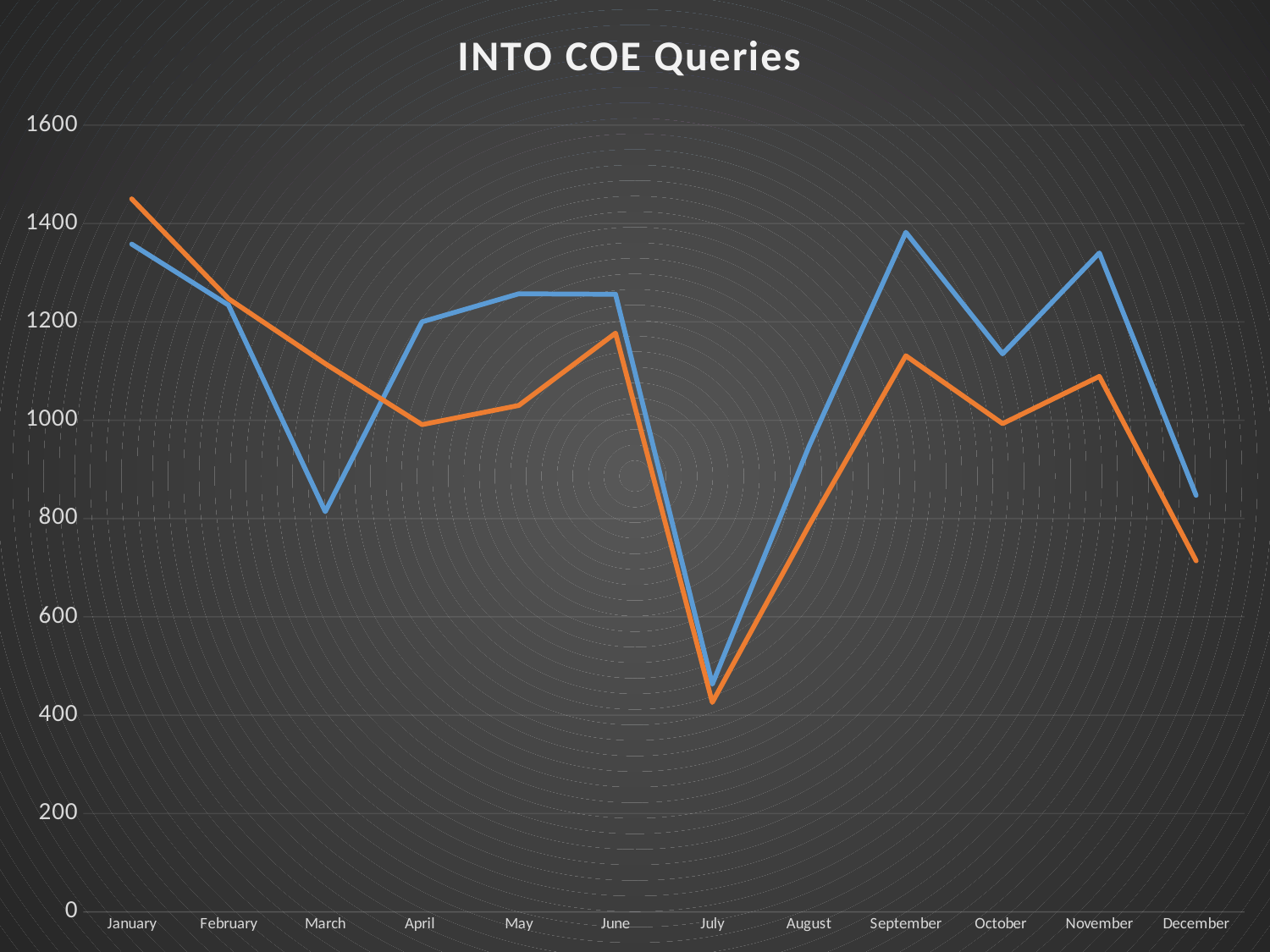
How many months are shown along the x axis? 12 Do the values of both lines rise or fall from June to July? fall How many lines are plotted on the chart? 2 Is the value of the orange line in January greater or less than 1400? greater In January, which line has the higher value, the blue line or the orange line? orange line Is the value of the blue line in March greater or less than 1000? less In which month is the blue line at its lowest? July What is the title of the chart? INTO COE Queries In which month is the orange line at its highest? January Is the value of the orange line in December greater or less than 800? less What kind of chart is shown on the slide? line chart In which month is the orange line at its lowest? July